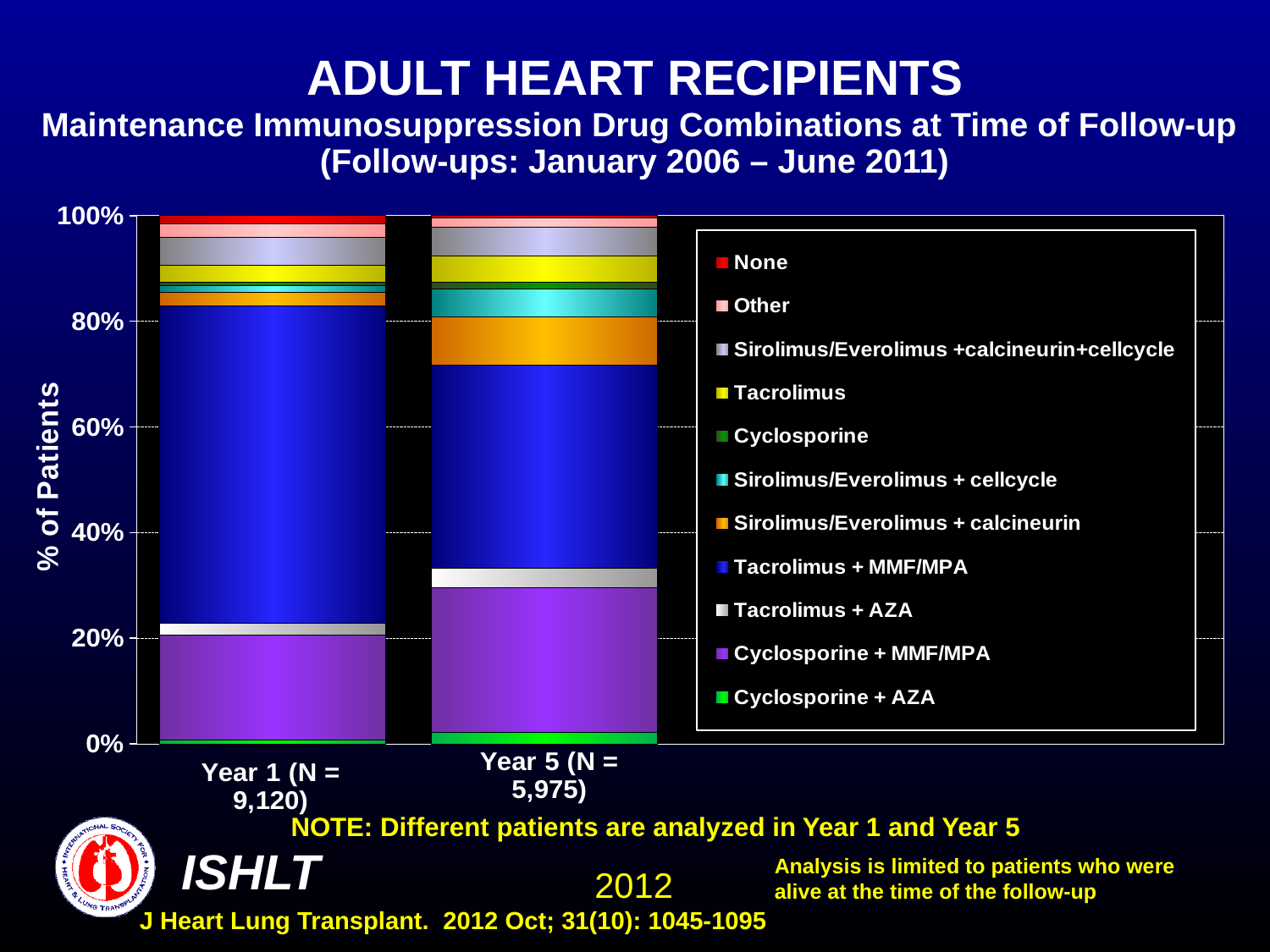
What is the label of the first bar on the x axis? Year 1 (N = 9,120) Is the Cyclosporine + MMF/MPA share of patients in Year 1 greater or less than 40%? less What kind of chart is shown on the slide? Stacked bar chart Which bar has the larger Sirolimus/Everolimus + calcineurin segment, Year 1 or Year 5? Year 5 How many bars (follow-up time points) are plotted on the chart? 2 What is the y-axis title of the chart? % of Patients Does the Tacrolimus + MMF/MPA share rise or fall from Year 1 to Year 5? fall Which bar has the larger Cyclosporine + MMF/MPA segment, Year 1 or Year 5? Year 5 How many series does the legend list? 11 Is the Tacrolimus + MMF/MPA share of patients in Year 1 greater or less than 40%? greater Which bar has the larger Tacrolimus + MMF/MPA segment, Year 1 or Year 5? Year 1 What is the N shown for Year 5? 5,975